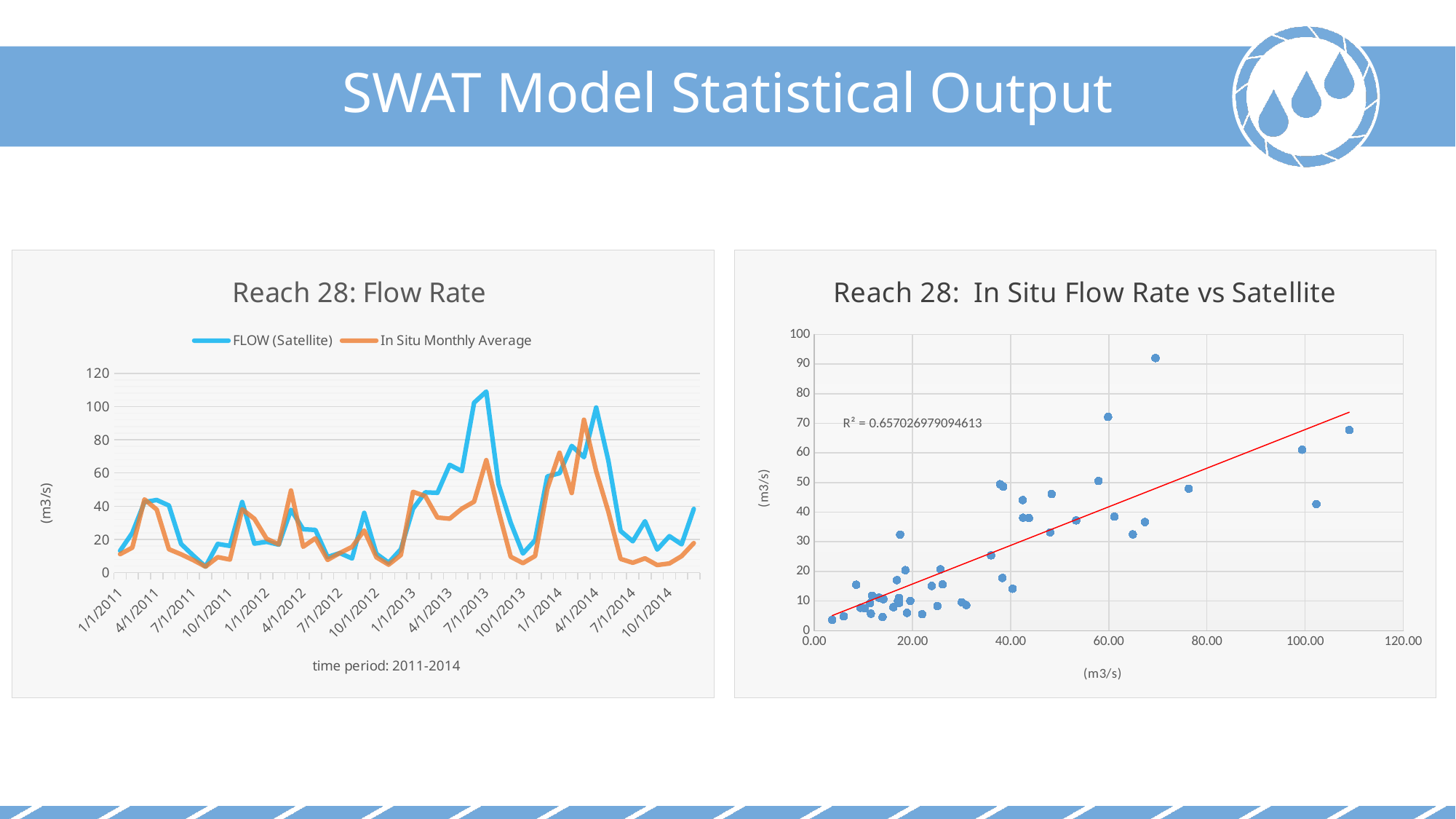
What is the x-axis title of the 'Reach 28: Flow Rate' chart? time period: 2011-2014 What kind of chart is the 'Reach 28: Flow Rate' chart on the left? line chart How many series does the legend of the 'Reach 28: Flow Rate' chart list? 2 In the 'Reach 28: Flow Rate' chart, is the peak of the In Situ Monthly Average series around 4/1/2014 greater or less than 80? greater In the 'Reach 28: Flow Rate' chart, is the peak of the FLOW (Satellite) series around 7/1/2013 greater or less than 100? greater What are the two series named in the legend of the 'Reach 28: Flow Rate' chart? FLOW (Satellite) and In Situ Monthly Average What is the maximum tick value shown on the x-axis of the 'Reach 28: In Situ Flow Rate vs Satellite' chart? 120.00 In the 'Reach 28: In Situ Flow Rate vs Satellite' chart, is the y-value of the highest point greater or less than 90? greater What R² value is printed on the 'Reach 28: In Situ Flow Rate vs Satellite' chart? 0.657026979094613 What kind of chart is the 'Reach 28: In Situ Flow Rate vs Satellite' chart on the right? scatter chart In the 'Reach 28: Flow Rate' chart, which series reaches the higher peak value? FLOW (Satellite)